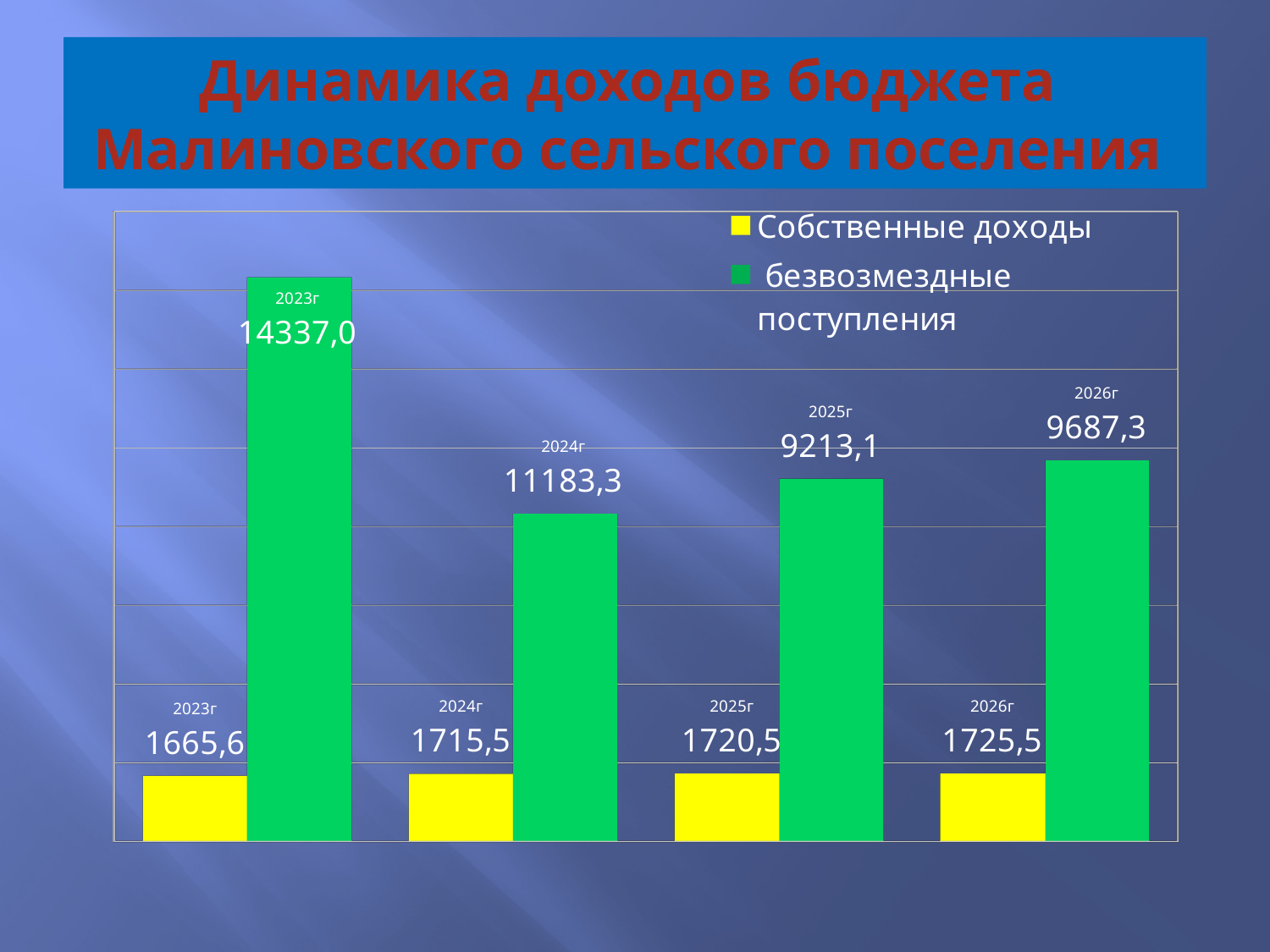
How many series does the legend list? 2 What is the value of Собственные доходы for 2026г? 1725,5 What kind of chart is shown on the slide? Bar chart In which year are Собственные доходы lowest? 2023г Which is larger: безвозмездные поступления in 2026г or in 2025г? 2026г What is the difference between безвозмездные поступления in 2023г and 2024г? 3153,7 What is the value of безвозмездные поступления for 2023г? 14337,0 What is the value of безвозмездные поступления for 2025г? 9213,1 What is the difference between Собственные доходы in 2026г and 2023г? 59,9 In which year are безвозмездные поступления highest? 2023г What is the value of Собственные доходы for 2024г? 1715,5